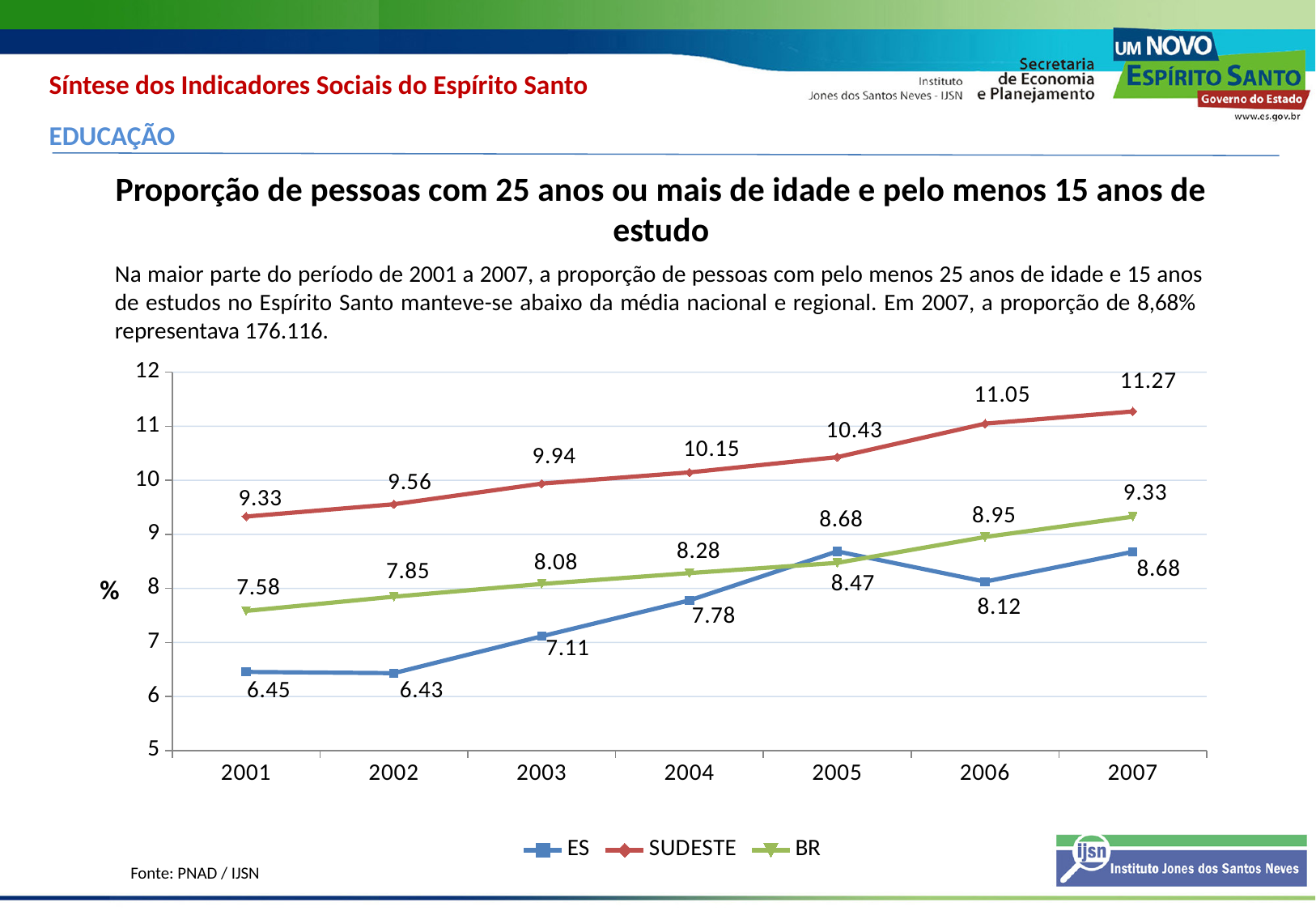
Which is larger in 2005, the ES value or the BR value? ES What is the label on the vertical axis of the chart? % In which year is the ES series at its lowest? 2002 In which year is the BR series at its highest? 2007 What is the value for ES in 2001? 6.45 How many years are shown on the x axis? 7 What kind of chart is shown on the slide? Line chart What is the value for BR in 2004? 8.28 How many series does the legend list? 3 What is the difference between the SUDESTE and ES values in 2007? 2.59 Does the SUDESTE series rise or fall from 2001 to 2007? Rise What is the value for SUDESTE in 2007? 11.27